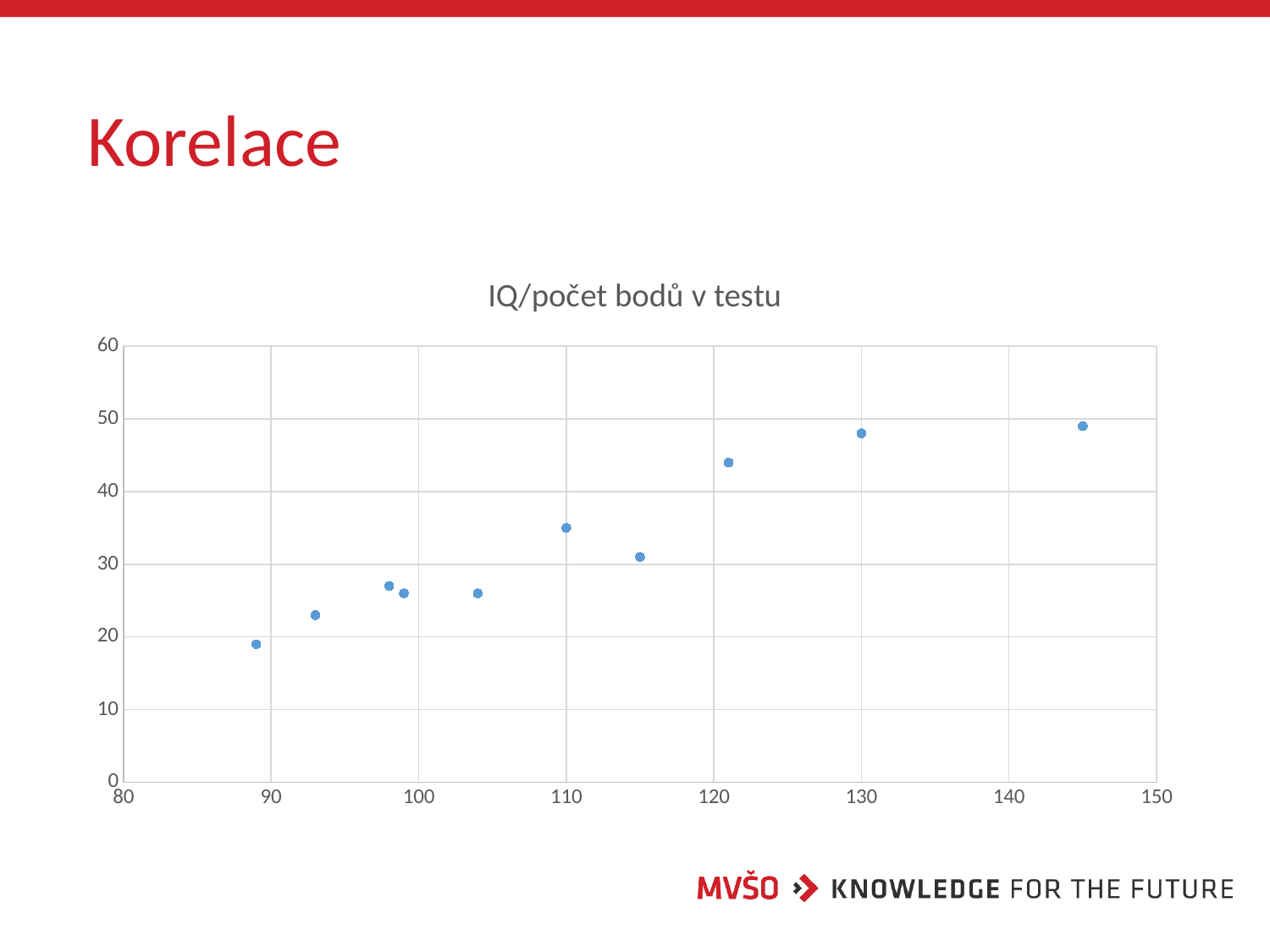
How many data points are plotted on the chart? 10 Is the value for the rightmost point (near IQ 145) greater or less than 40? greater Is the value for the point near IQ 121 greater or less than 40? greater What is the title of the chart? IQ/počet bodů v testu Is the value for the point at IQ 110 greater or less than 30? greater Which has the larger value: the leftmost point or the rightmost point? the rightmost point Do the plotted values generally rise or fall as IQ increases along the x axis? rise What kind of chart is shown on the slide? scatter chart Which has the larger value: the point at IQ 110 or the point at IQ 115? the point at IQ 110 What is the highest value shown on the y axis? 60